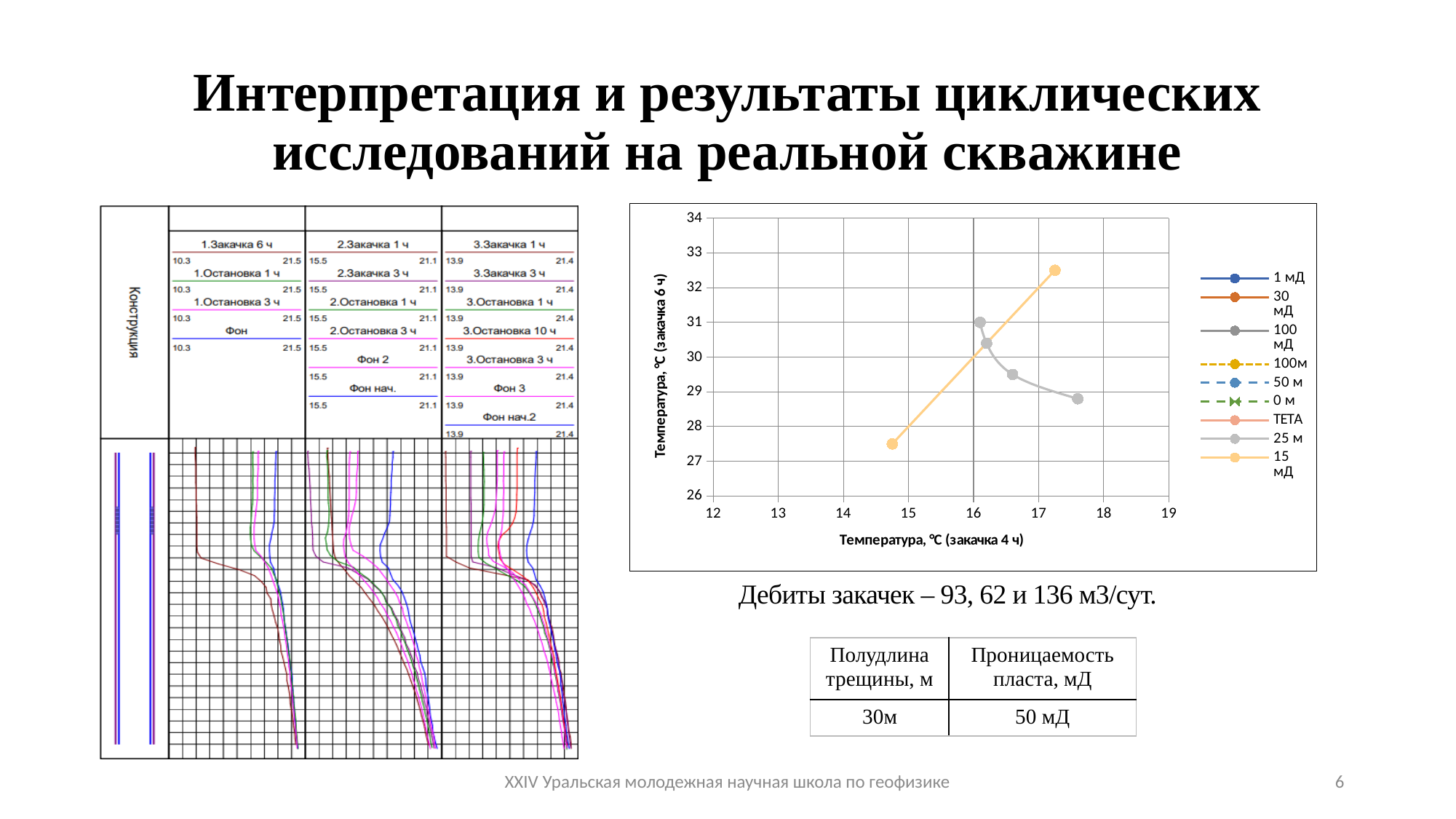
In the right-hand chart, how many data points does the orange line have? 2 In the right-hand chart, is the y value of the highest point of the orange line greater or less than 32? greater How many series does the legend of the right-hand chart list? 9 What kind of chart is shown on the right side of the slide? line chart In the right-hand chart, does the gray curve rise or fall as the x-axis temperature increases? fall What is the title of the x axis of the right-hand chart? Температура, °C (закачка 4 ч) In the right-hand chart, does the orange line rise or fall as the x-axis temperature increases? rise In the right-hand chart, is the y value of the lowest point of the orange line greater or less than 28? less In the right-hand chart, how many data points does the gray curve have? 4 In the right-hand chart, is the y value of the rightmost point of the gray curve greater or less than 29? less What is the title of the y axis of the right-hand chart? Температура, °C (закачка 6 ч) In the right-hand chart, which reaches a higher y value: the orange line or the gray curve? the orange line